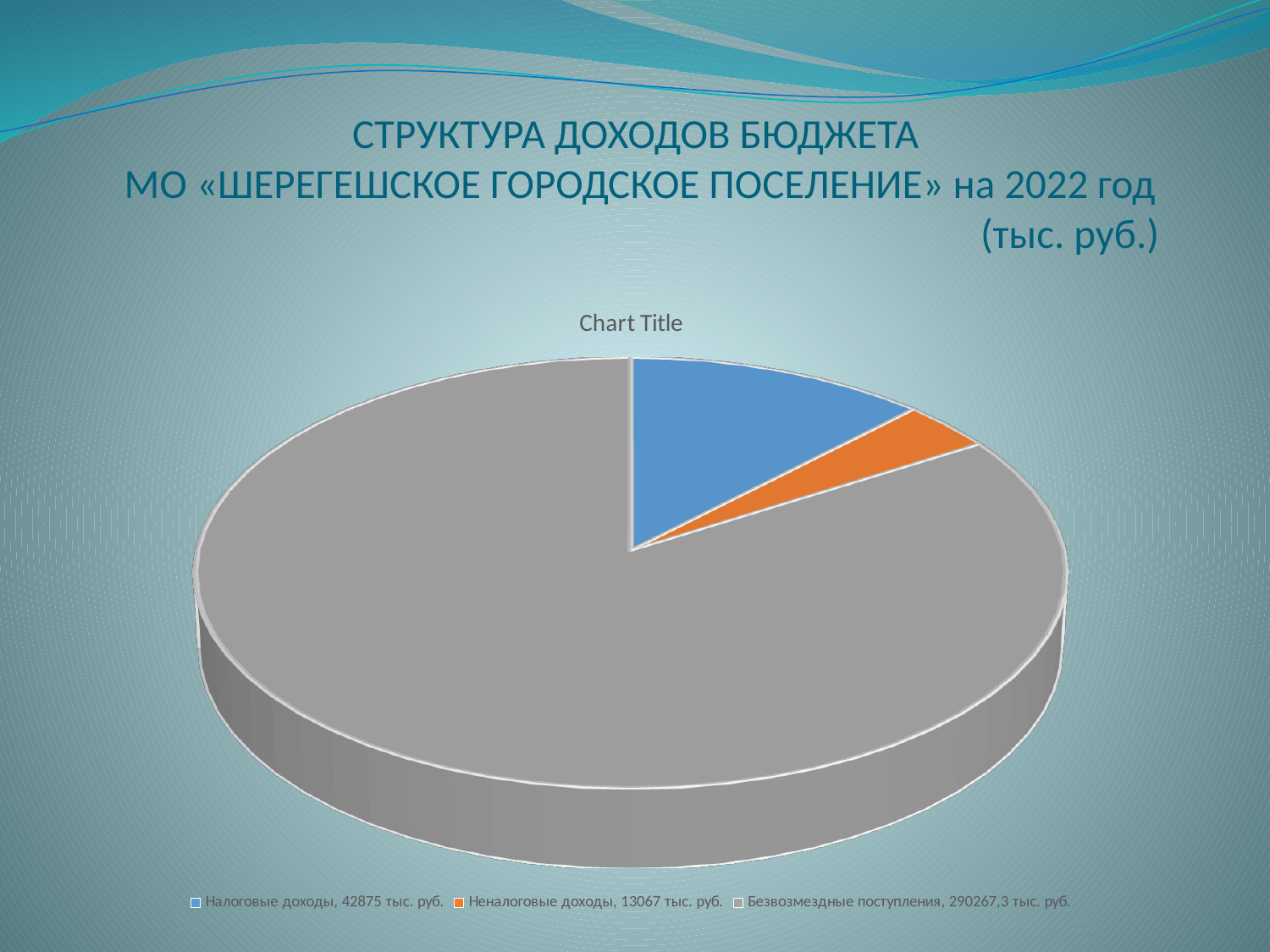
Which category has the smallest slice of the pie? Неналоговые доходы What is the difference between Налоговые доходы and Неналоговые доходы? 29808 тыс. руб. What is the total of all three categories shown in the legend? 346209,3 тыс. руб. Which category has the largest slice of the pie? Безвозмездные поступления What is the value for Безвозмездные поступления? 290267,3 тыс. руб. What title is printed directly above the pie chart? Chart Title What is the value for Неналоговые доходы? 13067 тыс. руб. How many categories does the pie chart show? 3 What type of chart is shown on the slide? Pie chart What colour is the slice for Налоговые доходы? Blue What is the value for Налоговые доходы? 42875 тыс. руб. Which is larger: Налоговые доходы or Неналоговые доходы? Налоговые доходы